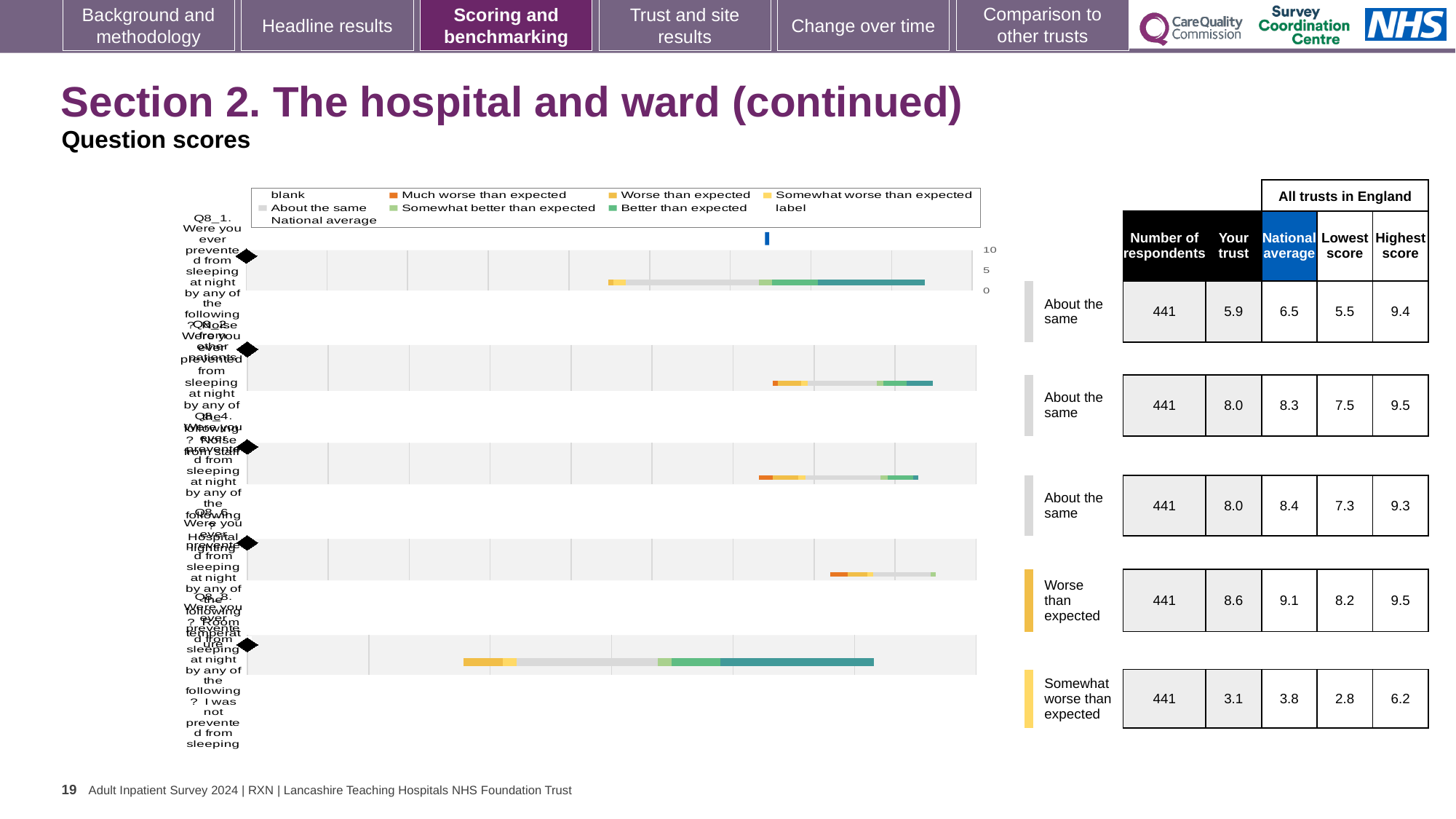
What colour does the legend use for 'Much worse than expected'? orange For the first (top) question row, which is larger: the 'Your trust' score or the national average? national average What colour does the legend use for 'Better than expected'? teal What kind of chart is shown on the slide? bar chart Which question row is rated 'Worse than expected'? the fourth row What is the 'Your trust' score for the first (top) question row? 5.9 Which question row has the lowest 'Your trust' score? the fifth (bottom) row, 3.1 What is the lowest score among all trusts in England for the fifth (bottom) question row? 2.8 What is the highest score among all trusts in England for the fourth question row? 9.5 For the fourth question row, what is the difference between the highest score (9.5) and the lowest score (8.2)? 1.3 What is the national average for the first (top) question row? 6.5 How many question rows (bars) are plotted in the chart? 5